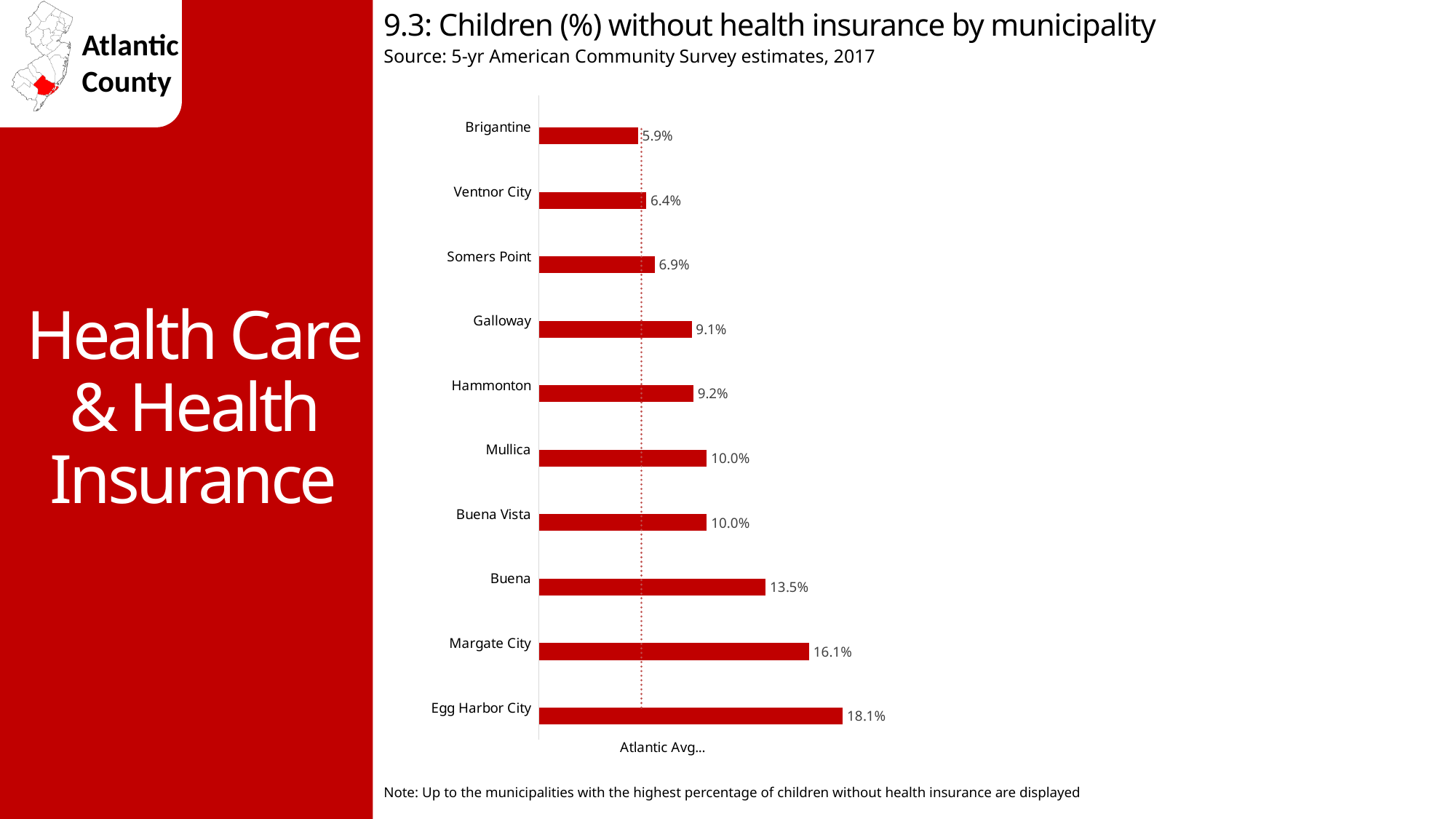
Which has a higher percentage of children without health insurance, Hammonton or Somers Point? Hammonton What type of chart is used on this slide? Bar chart Which municipality has the lowest percentage of children without health insurance? Brigantine How many municipalities are shown in the chart? 10 What percentage is shown for Ventnor City? 6.4% What is the value shown for Galloway? 9.1% Which has a higher value, Buena or Mullica? Buena What does the dotted vertical line in the chart represent? Atlantic Avg... What is the difference between the values for Margate City and Buena? 2.6% What is the difference between the values for Egg Harbor City and Brigantine? 12.2% Which municipality has the highest percentage of children without health insurance? Egg Harbor City What percentage of children are without health insurance in Egg Harbor City? 18.1%